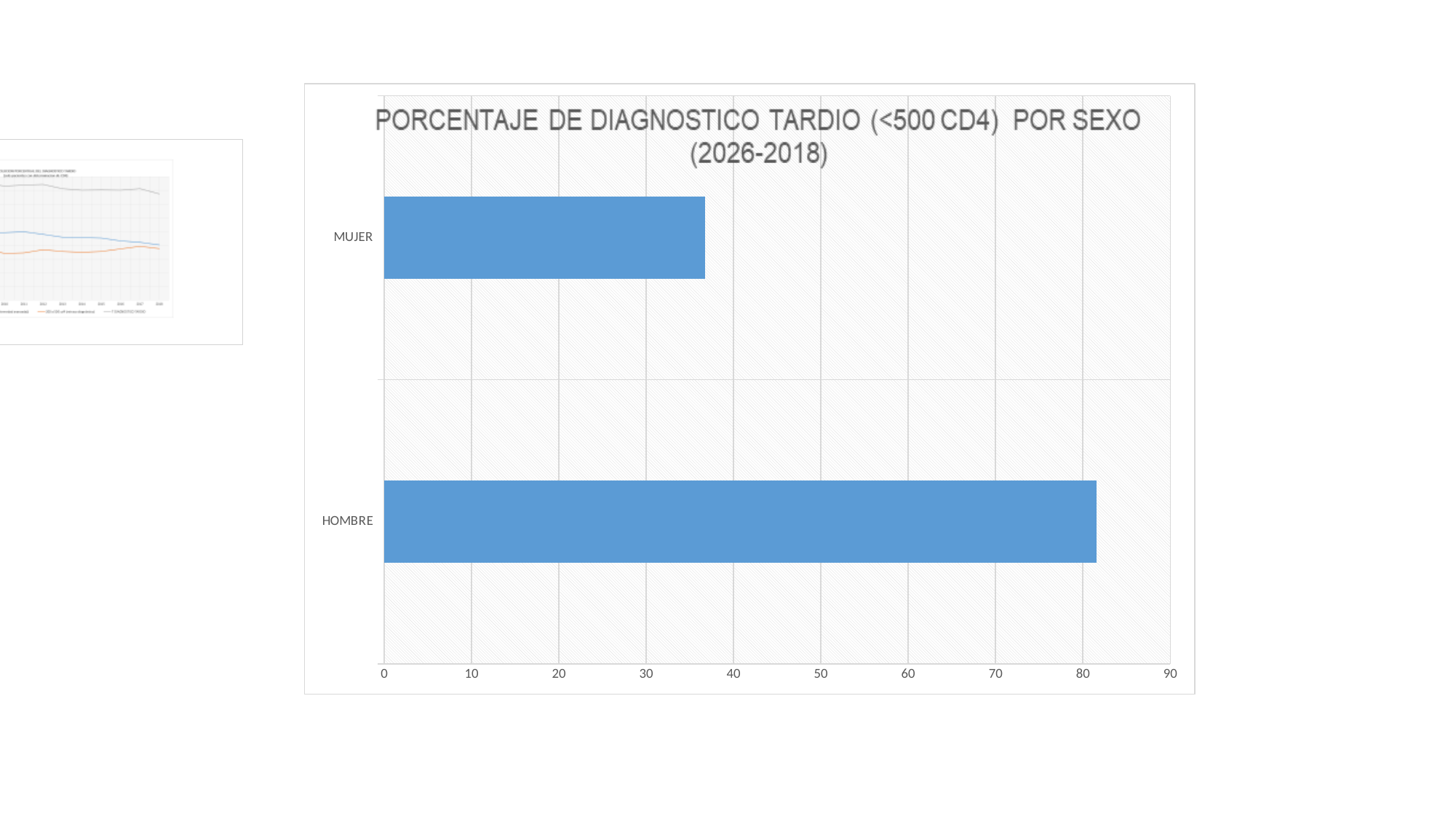
In the 'PORCENTAJE DE DIAGNOSTICO TARDIO (<500 CD4) POR SEXO' chart, is the value for MUJER greater or less than 30? greater What kind of chart is the 'PORCENTAJE DE DIAGNOSTICO TARDIO (<500 CD4) POR SEXO' chart? bar chart In the 'PORCENTAJE DE DIAGNOSTICO TARDIO (<500 CD4) POR SEXO' chart, is the value for HOMBRE greater or less than 90? less In the 'PORCENTAJE DE DIAGNOSTICO TARDIO (<500 CD4) POR SEXO' chart, which category has the highest value? HOMBRE In the 'PORCENTAJE DE DIAGNOSTICO TARDIO (<500 CD4) POR SEXO' chart, which category has the lowest value? MUJER What is the highest value shown on the horizontal axis of the 'PORCENTAJE DE DIAGNOSTICO TARDIO (<500 CD4) POR SEXO' chart? 90 What period is given in the title of the large bar chart on the slide? 2026-2018 How many categories are shown in the 'PORCENTAJE DE DIAGNOSTICO TARDIO (<500 CD4) POR SEXO' chart? 2 In the 'PORCENTAJE DE DIAGNOSTICO TARDIO (<500 CD4) POR SEXO' chart, which is larger, the value for HOMBRE or the value for MUJER? HOMBRE In the 'PORCENTAJE DE DIAGNOSTICO TARDIO (<500 CD4) POR SEXO' chart, is the value for HOMBRE greater or less than 70? greater